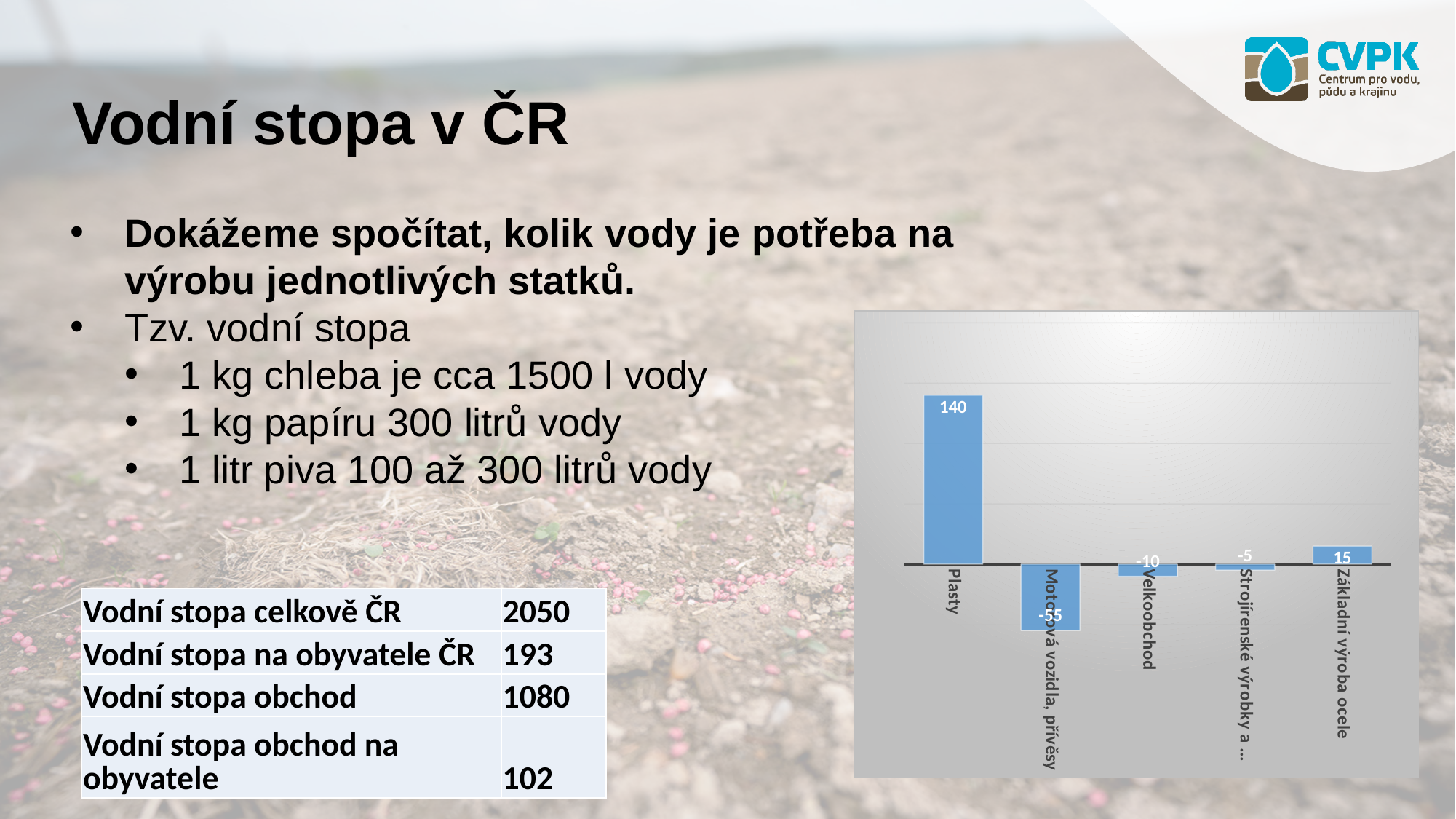
What is the value for Velkoobchod in the chart? -10 What kind of chart is shown on the slide? Bar chart How many categories in the chart have negative values? 3 How many categories are shown in the chart? 5 Which is larger, the value for Velkoobchod or the value for Základní výroba ocele? Základní výroba ocele What is the value for Základní výroba ocele in the chart? 15 What is the value for Plasty in the chart? 140 What colour are the bars in the chart? Blue Which category has the highest value in the chart? Plasty What is the value for Motorová vozidla, přívěsy in the chart? -55 What is the difference between the values for Plasty and Základní výroba ocele? 125 Which category has the lowest value in the chart? Motorová vozidla, přívěsy